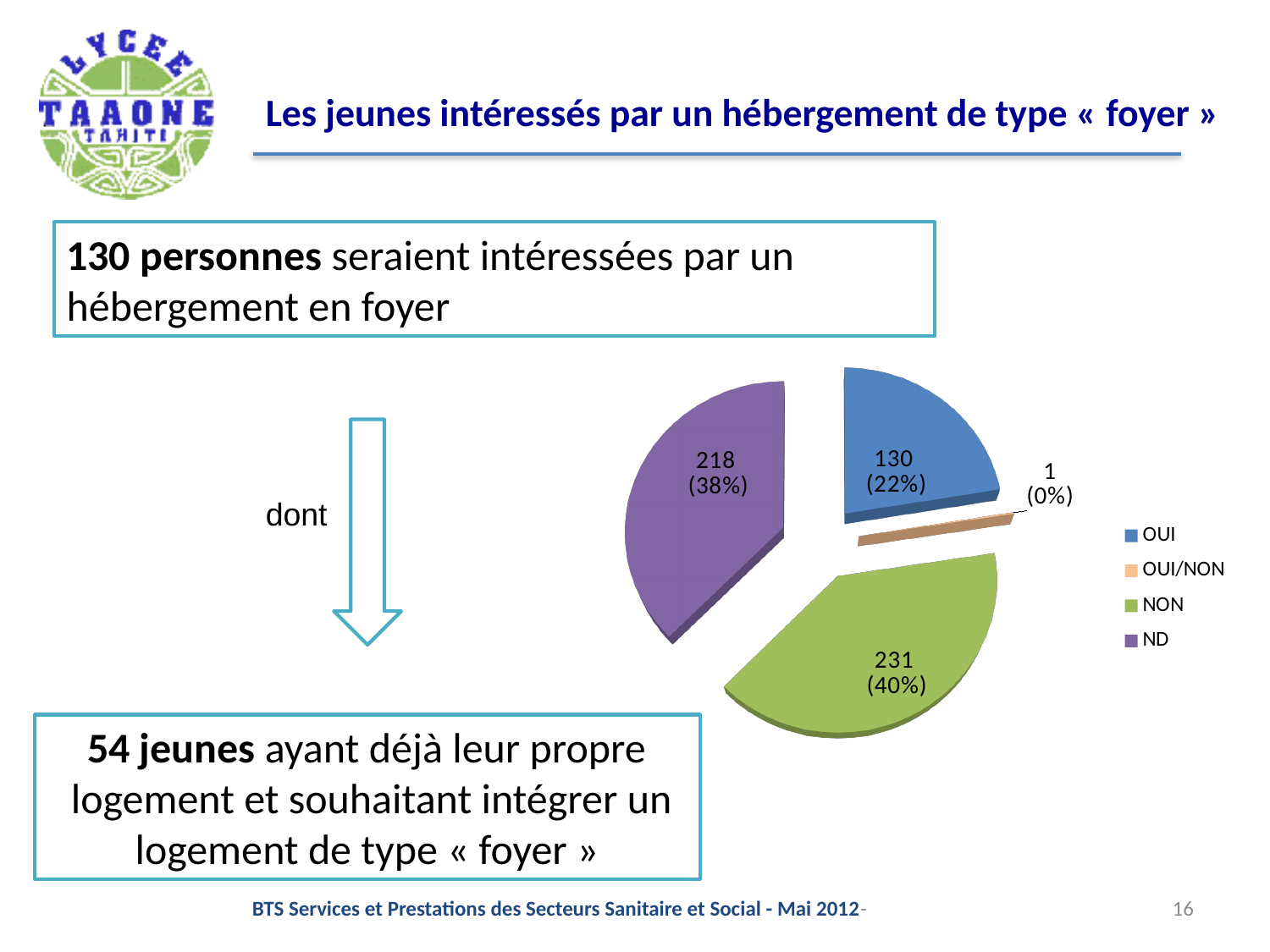
What is the value for the NON slice of the pie chart? 231 What is the value for the OUI slice of the pie chart? 130 What is the value for the ND slice of the pie chart? 218 What share of the pie does the ND slice represent? 38% What is the difference between the NON value and the OUI value in the pie chart? 101 Which category has the smallest slice in the pie chart? OUI/NON What share of the pie does the OUI slice represent? 22% What kind of chart is shown on the slide? pie chart How many categories does the legend of the pie chart list? 4 What is the value for the OUI/NON slice of the pie chart? 1 Which category has the largest slice in the pie chart? NON Which is larger in the pie chart, the NON slice or the ND slice? NON